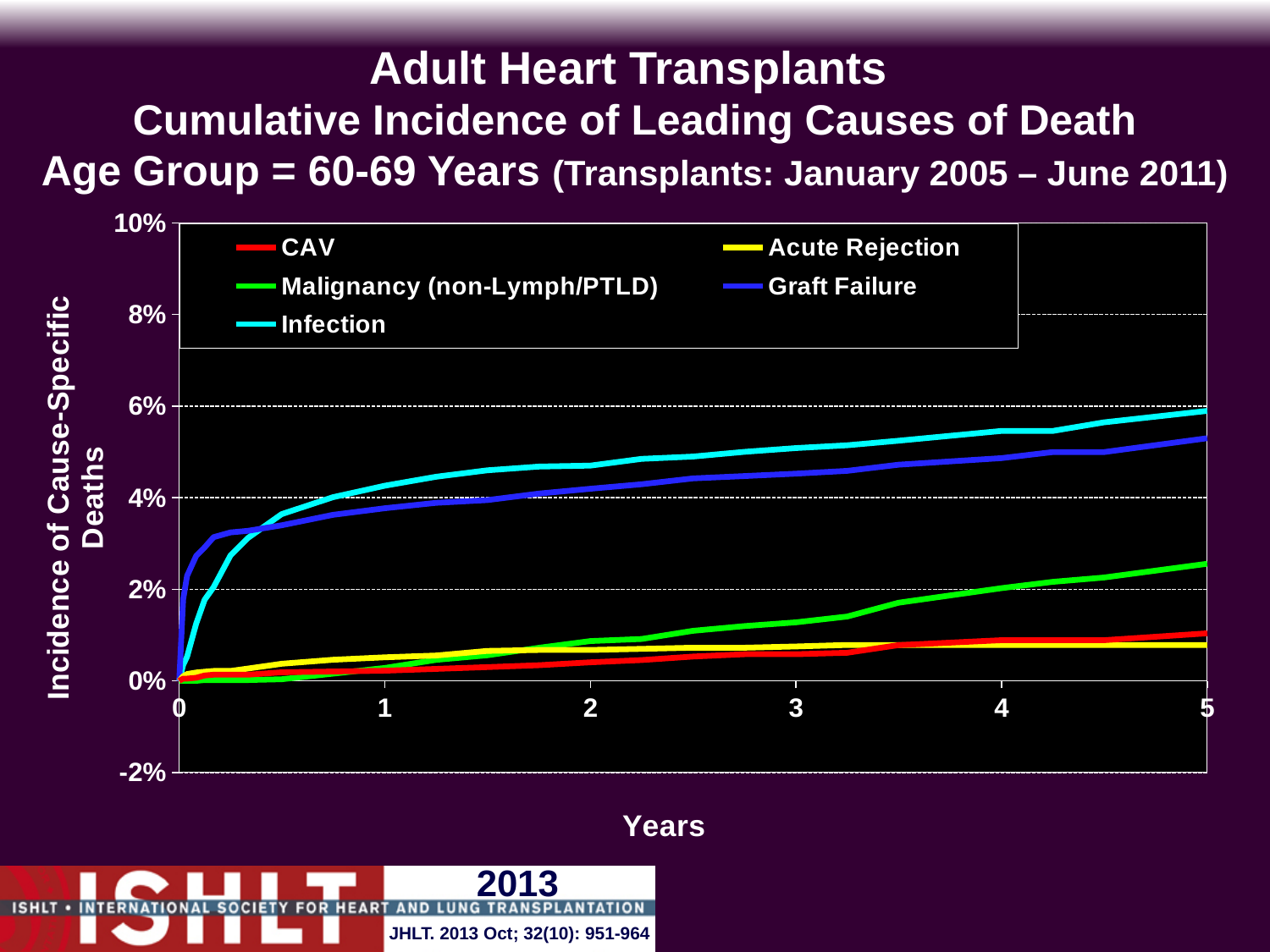
Is the value for Infection at year 5 greater or less than 4%? greater At year 5, which is higher: Malignancy (non-Lymph/PTLD) or Graft Failure? Graft Failure Is the value for Malignancy (non-Lymph/PTLD) at year 3 greater or less than 2%? less Does the Infection line rise or fall as years increase? rise Is the value for Graft Failure at year 5 greater or less than 6%? less What kind of chart is shown on the slide? line chart What colour is the Graft Failure line in the legend? blue How many series does the legend list? 5 Which cause of death has the highest cumulative incidence at year 5? Infection At year 5, which is higher: Infection or Graft Failure? Infection